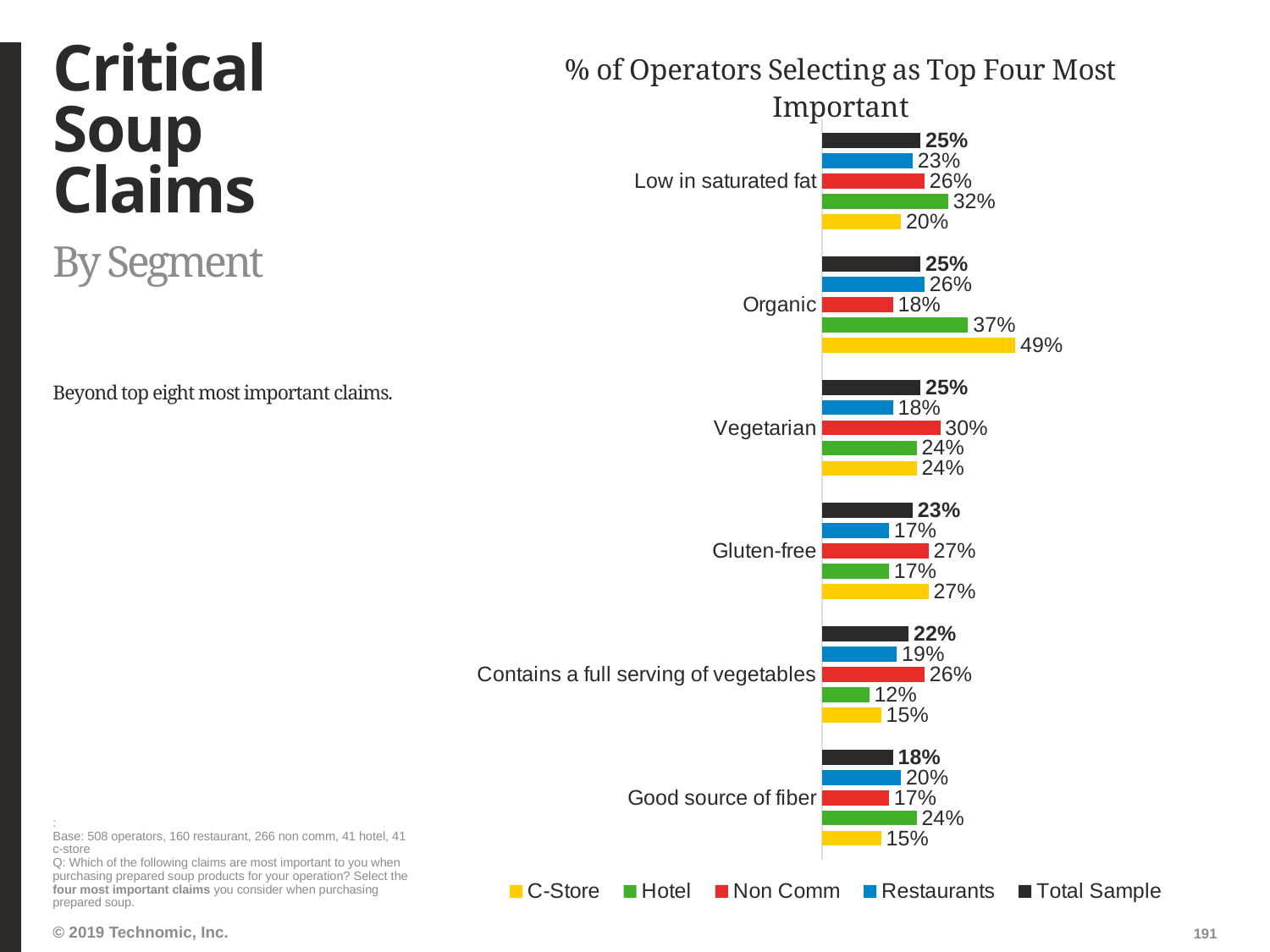
What percentage of Hotel operators selected Low in saturated fat? 32% For Good source of fiber, which is larger: the Hotel value or the Restaurants value? Hotel What is the difference between the C-Store and Hotel values for Organic? 12% How many claims are shown on the chart? 6 Which colour represents Non Comm in the chart? Red What is the Non Comm value for Vegetarian? 30% Which claim has the lowest Hotel value? Contains a full serving of vegetables What type of chart is shown on the slide? Bar chart Which claim has the highest C-Store value? Organic What is the Total Sample value for Gluten-free? 23% What percentage of C-Store operators selected Organic as a top four most important claim? 49% How many series does the legend list? 5